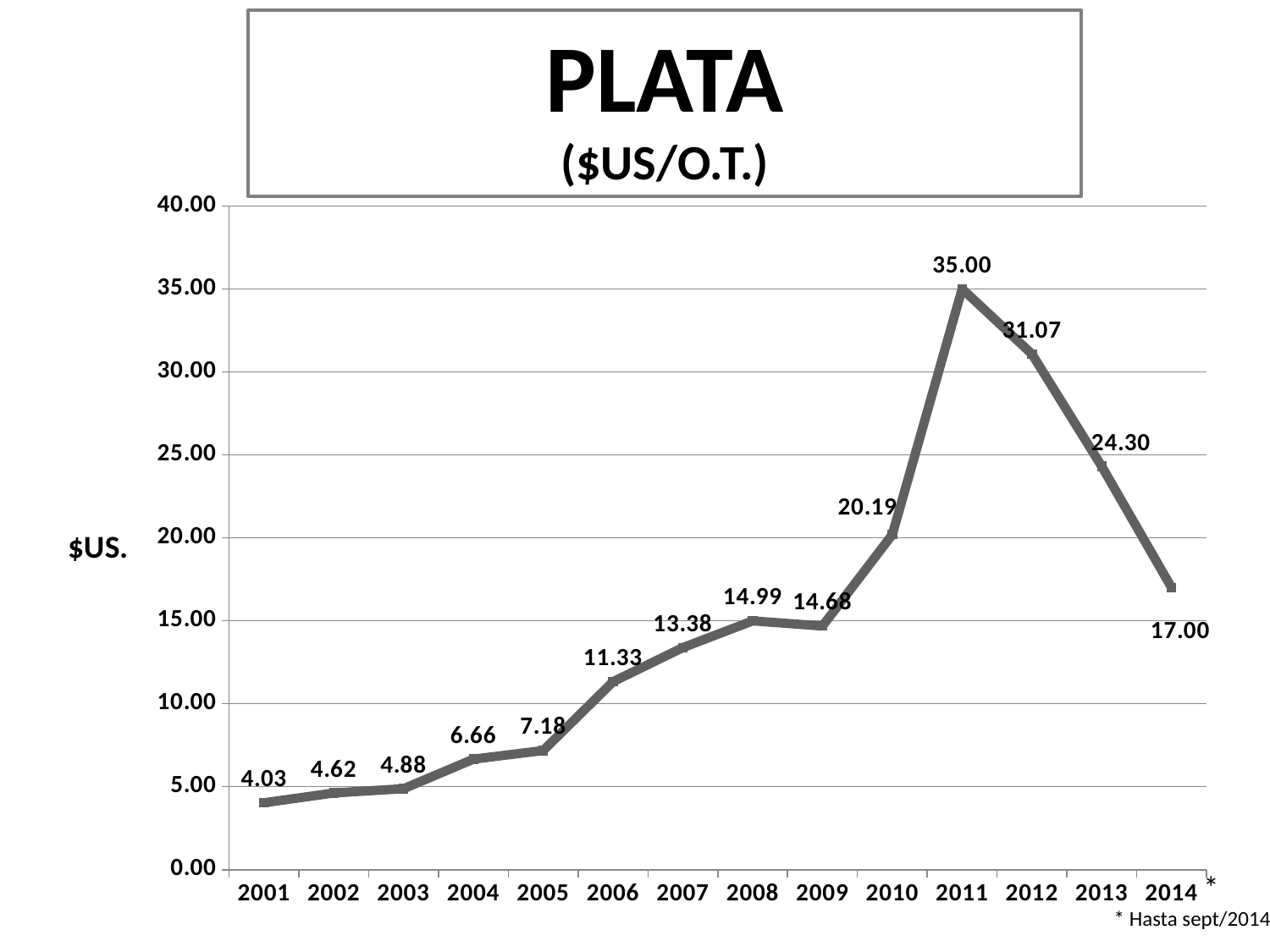
What is the value for 2011? 35.00 Which year has the highest value? 2011 Which year has the lowest value? 2001 Which is larger, the value for 2008 or the value for 2009? 2008 Do the values rise or fall from 2011 to 2014? fall How many years are plotted on the x axis? 14 What is the value for 2001? 4.03 Is the value for 2010 greater or less than 20.00? greater What kind of chart is shown? line chart What is the title of the chart? PLATA ($US/O.T.) What is the difference between the values for 2011 and 2012? 3.93 What is the value for 2014? 17.00